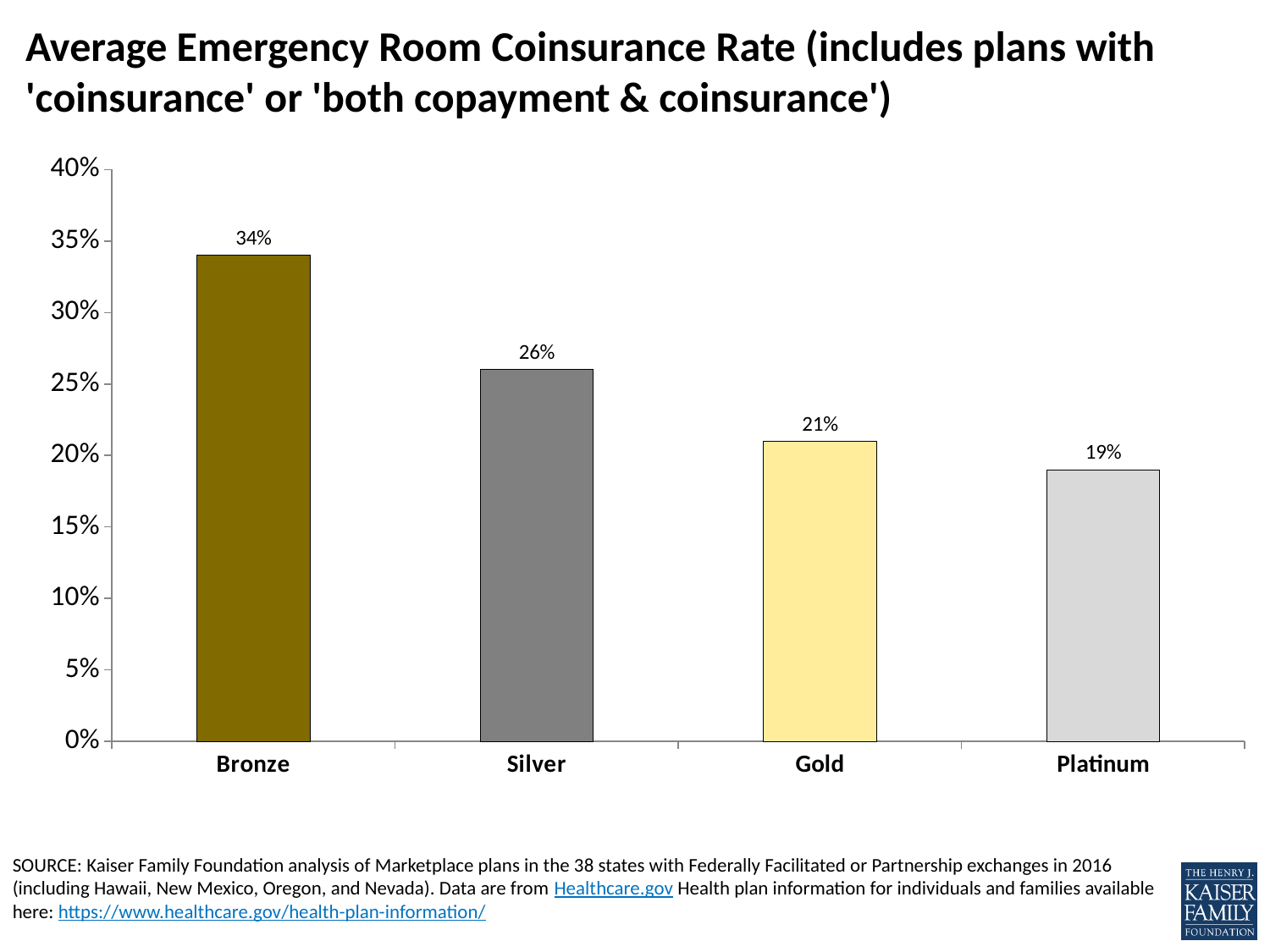
What is the difference between the Gold and Platinum average emergency room coinsurance rates? 2% Which has a higher average emergency room coinsurance rate, Silver or Gold? Silver What is the difference between the Bronze and Silver average emergency room coinsurance rates? 8% What is the average emergency room coinsurance rate for Bronze plans? 34% What is the average emergency room coinsurance rate for Platinum plans? 19% Do the values rise or fall moving from Bronze to Platinum along the x axis? Fall Which plan tier has the highest average emergency room coinsurance rate? Bronze Which plan tier has the lowest average emergency room coinsurance rate? Platinum How many plan tiers are shown on the chart? 4 What is the average emergency room coinsurance rate for Gold plans? 21% What kind of chart is shown on the slide? Bar chart What is the average emergency room coinsurance rate for Silver plans? 26%